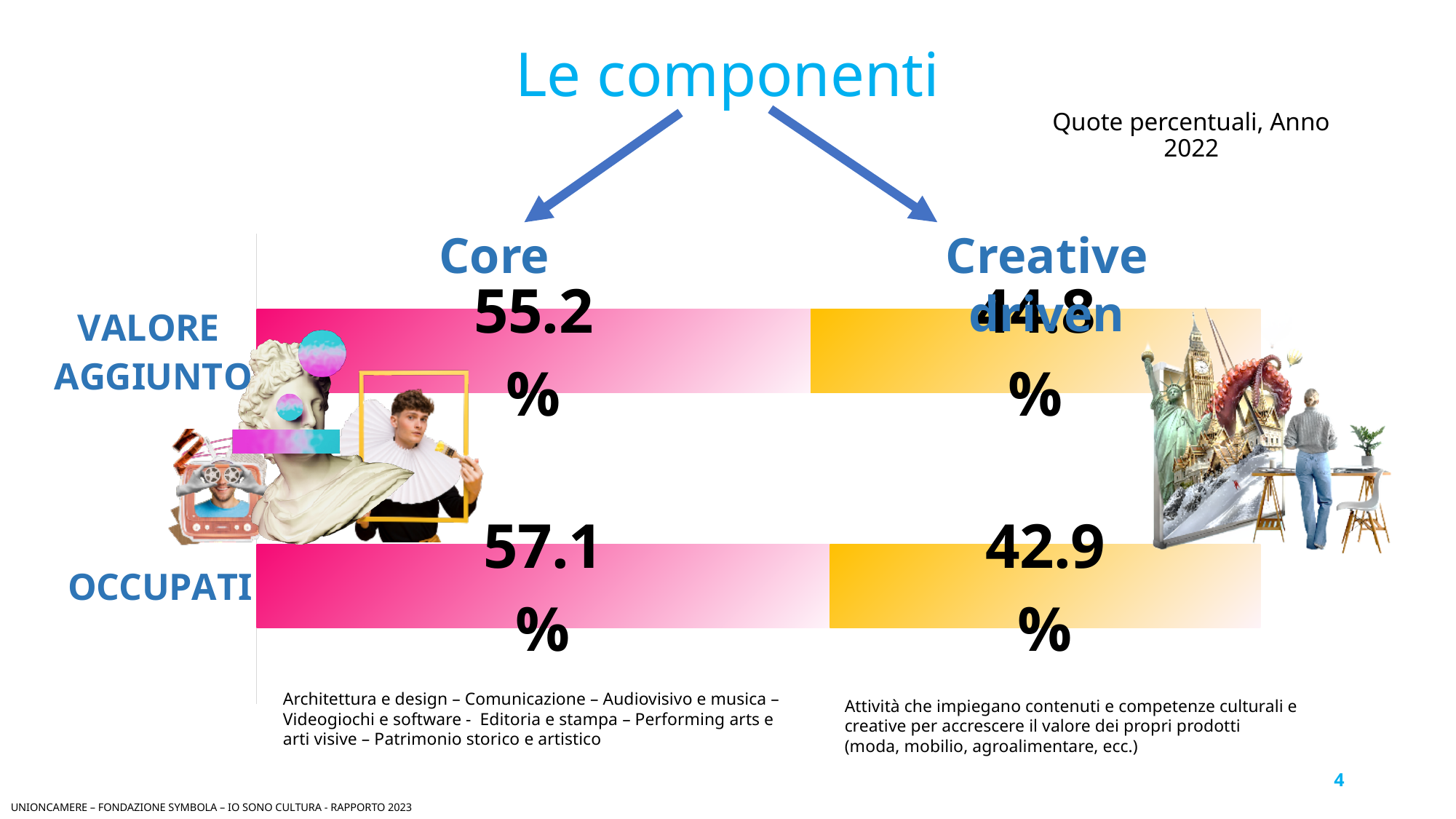
What is the Core share of Valore aggiunto? 55.2% Which component has the larger share of Valore aggiunto, Core or Creative driven? Core How many categories (rows) does the chart show? 2 What is the total of the Core and Creative driven shares for Valore aggiunto? 100% What is the Core share of Occupati? 57.1% What is the difference between the Core and Creative driven shares of Occupati? 14.2% What is the Creative driven share of Occupati? 42.9% What is the Creative driven share of Valore aggiunto? 44.8% How many components (series) are shown in the chart? 2 What kind of chart is shown on the slide? Stacked bar chart Which component has the larger share of Occupati, Core or Creative driven? Core What is the difference between the Core share of Occupati and the Core share of Valore aggiunto? 1.9%